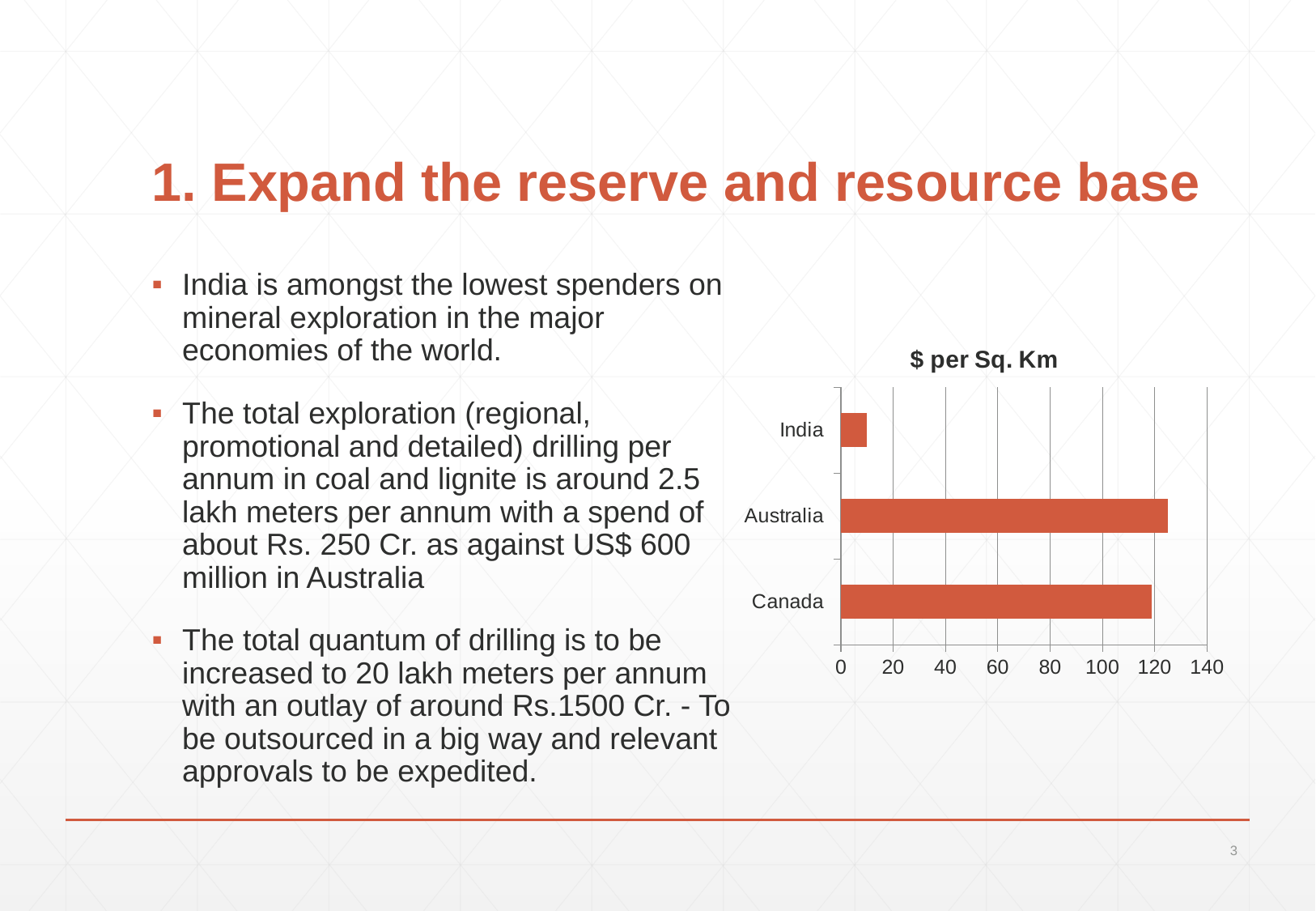
What kind of chart is shown on the slide? bar chart Which country has the highest value in the chart? Australia Is the value for India greater or less than 20? less Which country has the lowest value in the chart? India Which is larger, the value for Australia or the value for India? Australia Is the value for Australia greater or less than 100? greater What is the title of the chart? $ per Sq. Km Is the value for Australia greater or less than 120? greater Which is larger, the value for India or the value for Canada? Canada How many countries are shown in the chart? 3 What is the highest value shown on the chart's horizontal axis? 140